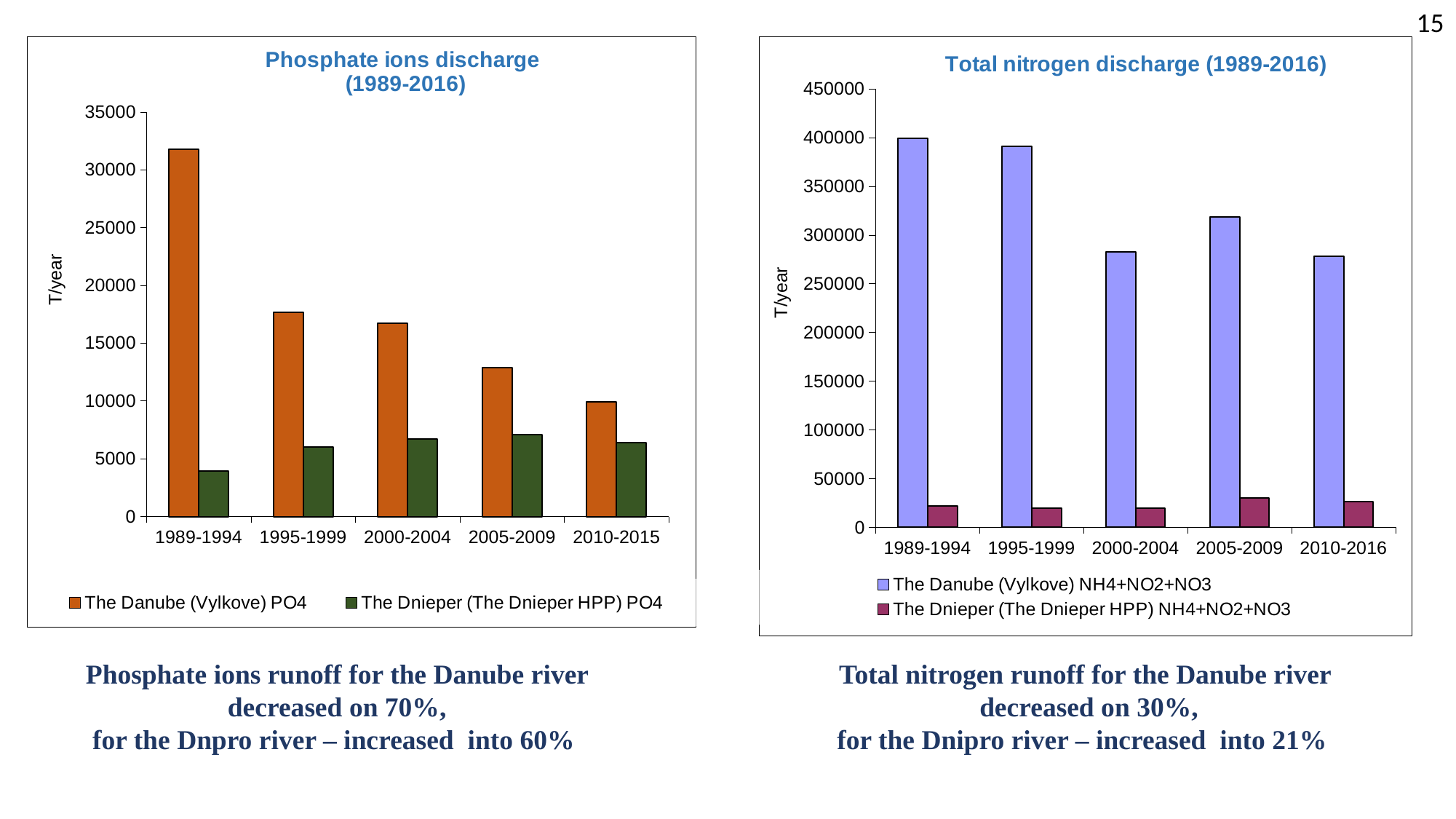
What kind of chart is the 'Phosphate ions discharge (1989-2016)' chart? bar chart In the 'Phosphate ions discharge (1989-2016)' chart, is the value for The Dnieper (The Dnieper HPP) PO4 in 1989-1994 greater or less than 5000? less How many time periods are shown on the x axis of the 'Phosphate ions discharge (1989-2016)' chart? 5 What is the y-axis label of the 'Total nitrogen discharge (1989-2016)' chart? T/year In the 'Total nitrogen discharge (1989-2016)' chart, which period has the highest value for The Dnieper (The Dnieper HPP) NH4+NO2+NO3? 2005-2009 In the 'Phosphate ions discharge (1989-2016)' chart, which period has the highest value for The Danube (Vylkove) PO4? 1989-1994 How many series does the legend of the 'Phosphate ions discharge (1989-2016)' chart list? 2 In the 'Total nitrogen discharge (1989-2016)' chart, is the value for The Danube (Vylkove) NH4+NO2+NO3 in 2000-2004 greater or less than 300000? less How many series does the legend of the 'Total nitrogen discharge (1989-2016)' chart list? 2 In the 'Phosphate ions discharge (1989-2016)' chart, which series has the larger value in 2010-2015? The Danube (Vylkove) PO4 In the 'Phosphate ions discharge (1989-2016)' chart, do the values for The Danube (Vylkove) PO4 rise or fall across the periods from 1989-1994 to 2010-2015? fall In the 'Phosphate ions discharge (1989-2016)' chart, is the value for The Danube (Vylkove) PO4 in 1989-1994 greater or less than 30000? greater